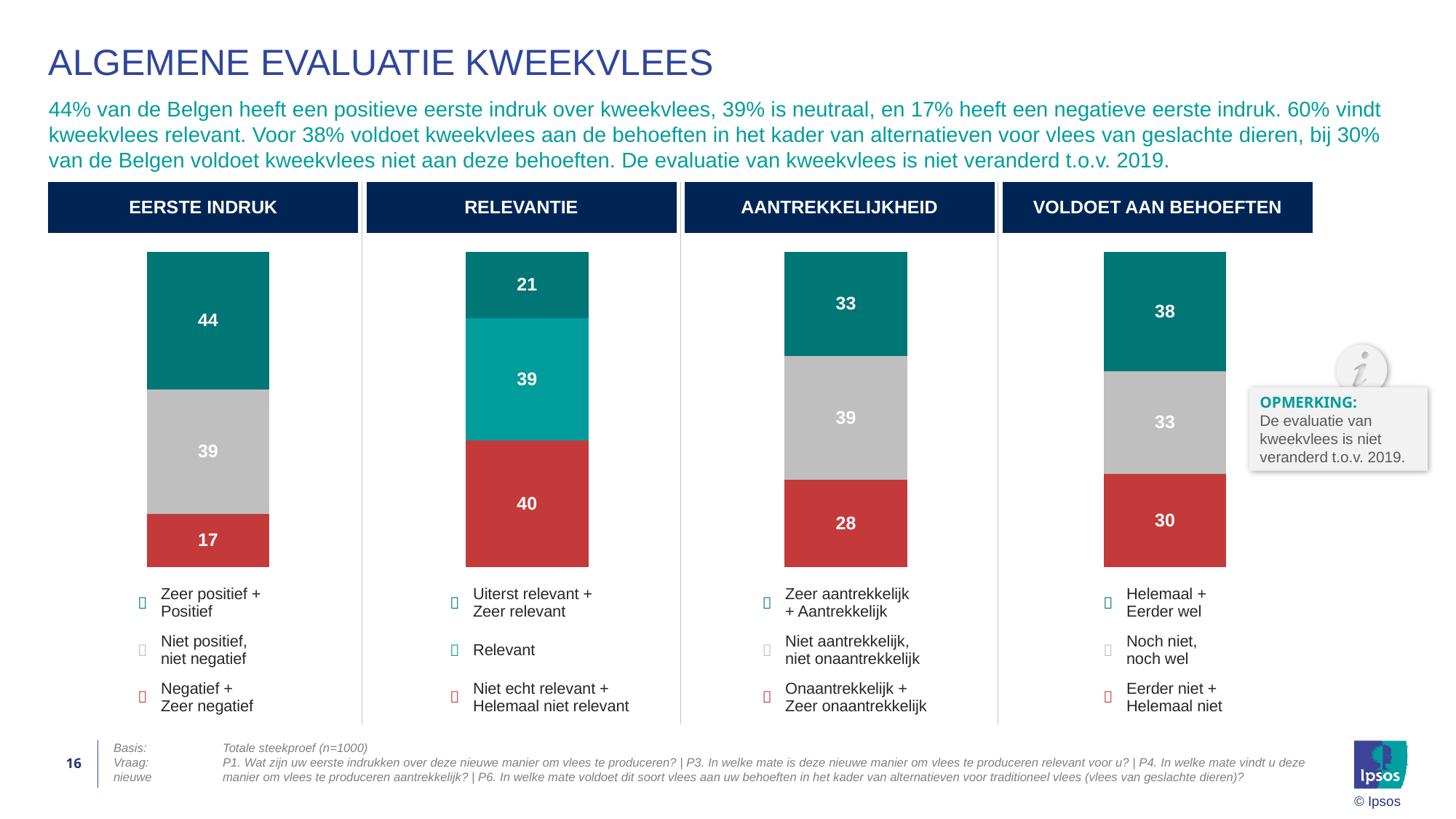
In the RELEVANTIE chart, what is the value for 'Relevant'? 39 In the EERSTE INDRUK chart, what is the value for 'Zeer positief + Positief'? 44 In the EERSTE INDRUK chart, what is the total of the stacked bar? 100 How many segments does the stacked bar in the RELEVANTIE chart have? 3 In the VOLDOET AAN BEHOEFTEN chart, which is larger: 'Noch niet, noch wel' or 'Eerder niet + Helemaal niet'? Noch niet, noch wel In the VOLDOET AAN BEHOEFTEN chart, what is the value for 'Helemaal + Eerder wel'? 38 In the AANTREKKELIJKHEID chart, what is the difference between 'Niet aantrekkelijk, niet onaantrekkelijk' and 'Zeer aantrekkelijk + Aantrekkelijk'? 6 In the RELEVANTIE chart, which segment has the largest value? Niet echt relevant + Helemaal niet relevant In the RELEVANTIE chart, which segment has the smallest value? Uiterst relevant + Zeer relevant In the EERSTE INDRUK chart, what is the value for 'Negatief + Zeer negatief'? 17 In the AANTREKKELIJKHEID chart, what is the value for 'Onaantrekkelijk + Zeer onaantrekkelijk'? 28 What type of chart is used in the AANTREKKELIJKHEID panel? Stacked bar chart